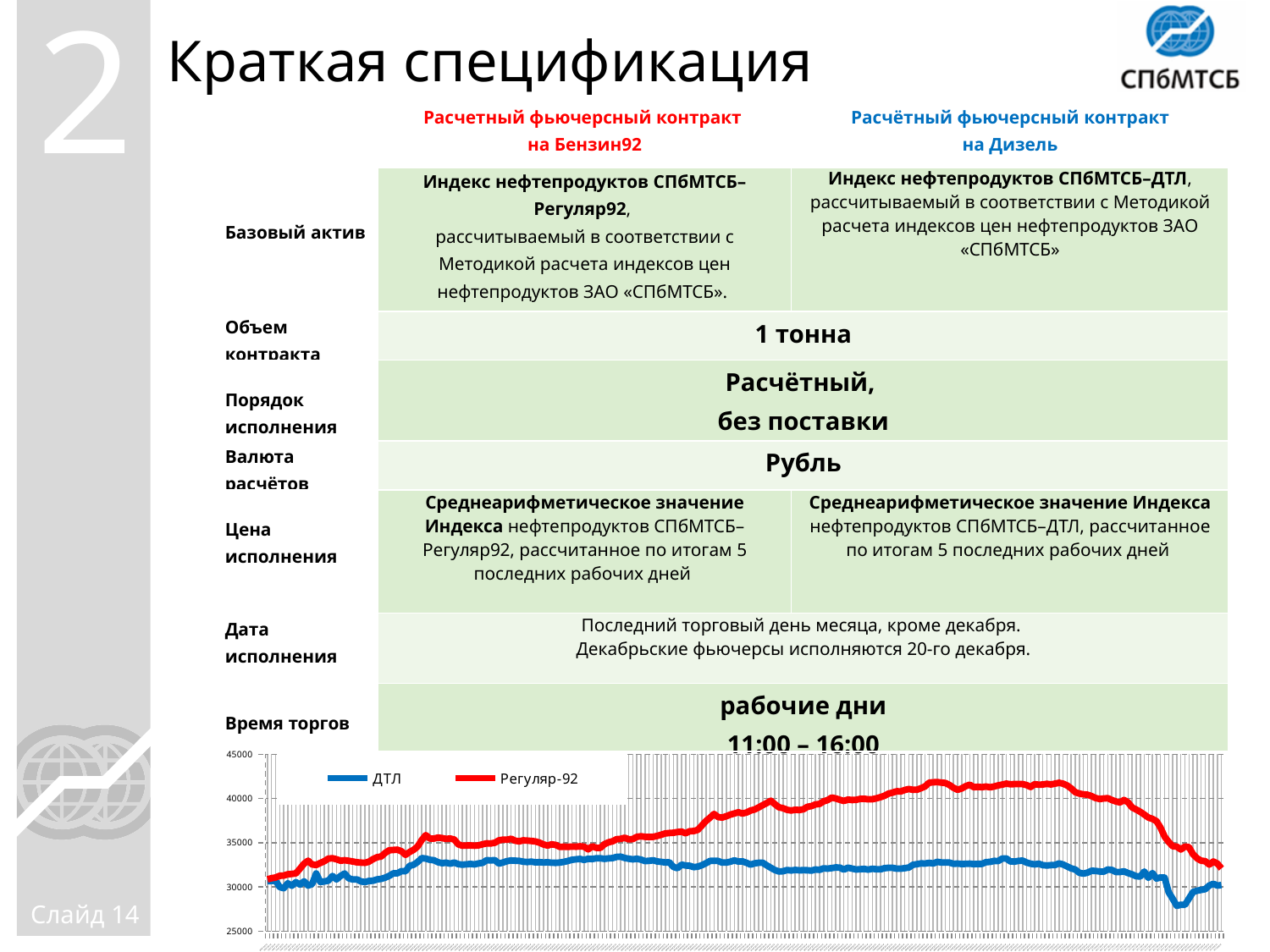
Which series reaches the higher peak in the chart, ДТЛ or Регуляр-92? Регуляр-92 At the right end of the chart, which series is higher, ДТЛ or Регуляр-92? Регуляр-92 Is the highest value of the ДТЛ line greater or less than 35000? less How many series does the legend of the chart list? 2 Is the lowest value of the ДТЛ line greater or less than 30000? less Is the value of the Регуляр-92 line at the start of the period greater or less than 35000? less What kind of chart is shown at the bottom of the slide? line chart What are the two series named in the chart legend? ДТЛ and Регуляр-92 What is the lowest value shown on the vertical axis of the chart? 25000 What colour is the ДТЛ line in the chart? blue